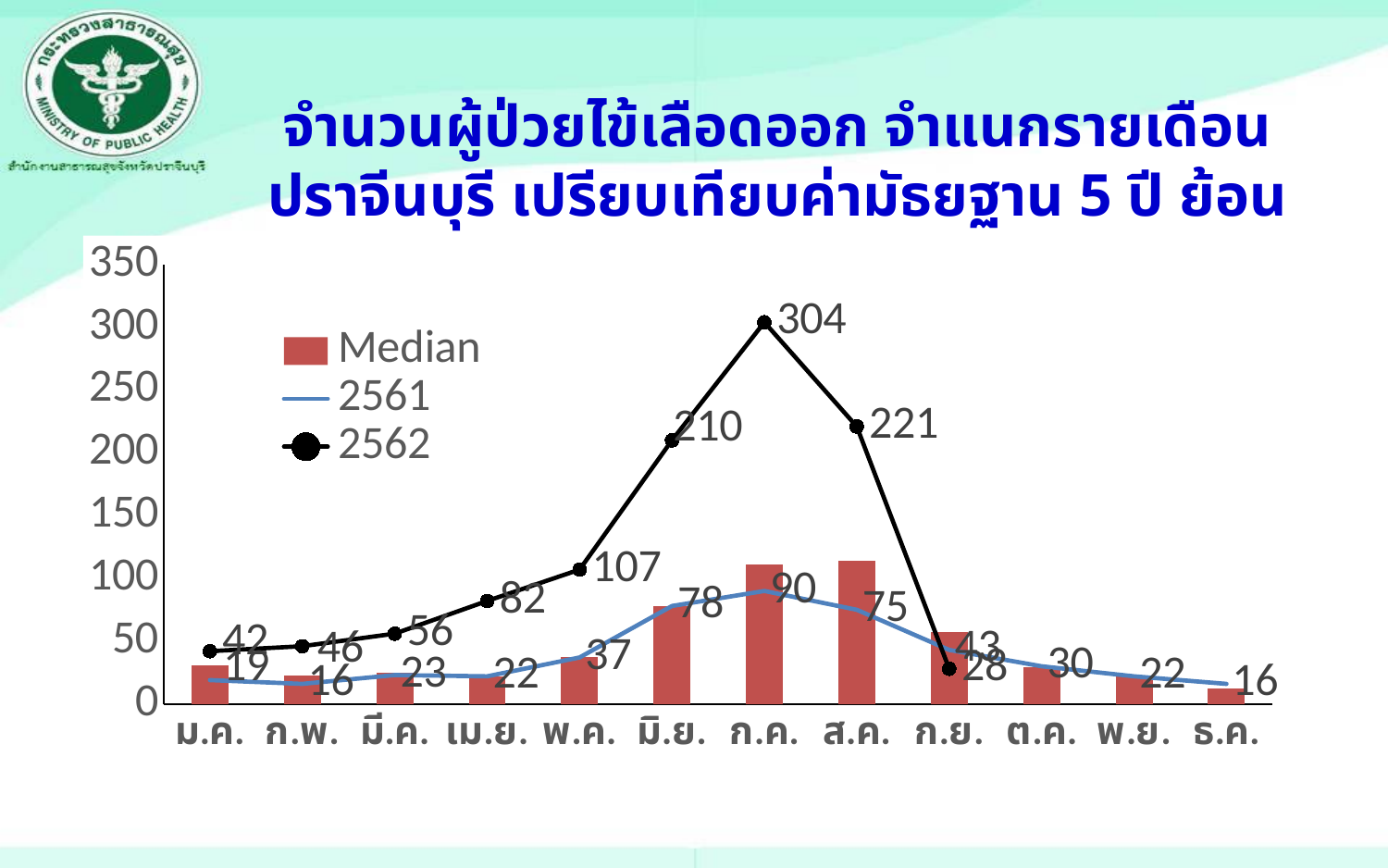
What kind of chart is shown on the slide? Combined bar and line chart Is the Median bar for ส.ค. greater or less than 50? greater What is the value of the 2561 series in ธ.ค.? 16 What is the value of the 2562 series in ก.ค.? 304 In มิ.ย., which series has the larger value, 2561 or 2562? 2562 What is the value of the 2561 series in ก.ค.? 90 Does the 2562 series rise or fall from ม.ค. to ก.ค.? rise How many months are shown on the x axis? 12 What is the value of the 2562 series in ก.ย.? 28 How many series does the legend list? 3 In which month does the 2562 series reach its highest value? ก.ค. What is the difference between the 2562 values in ก.ค. and ส.ค.? 83